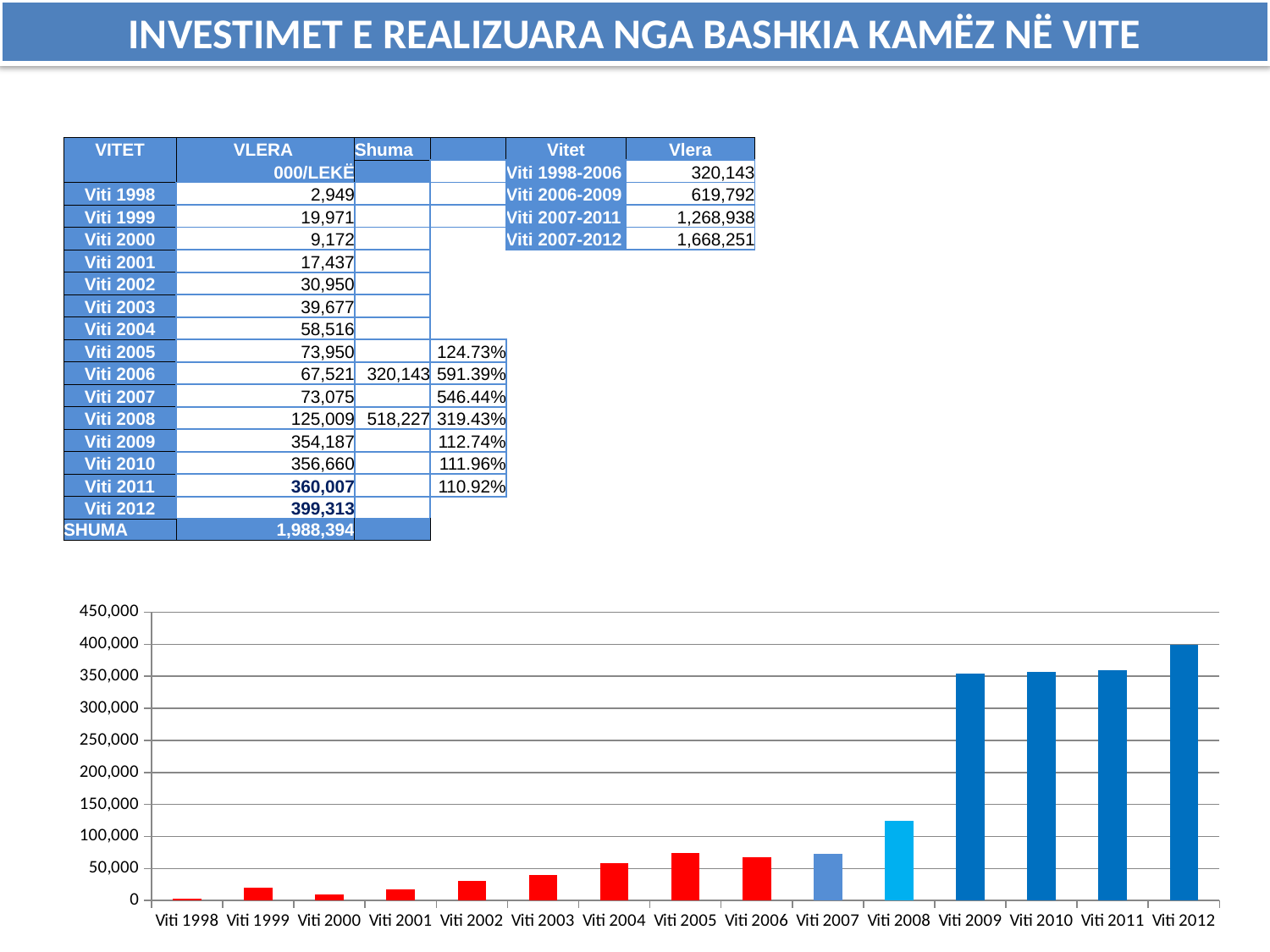
Which year has the tallest bar in the chart? Viti 2012 Do the bar values generally rise or fall from Viti 1998 to Viti 2012? rise Is the bar for Viti 2008 greater or less than 100,000? greater According to the table, what is the value (000/LEKË) for Viti 2012? 399,313 How many years (categories) are plotted on the x axis of the bar chart? 15 According to the table, what is the difference between the values for Viti 2012 and Viti 2011? 39,306 Is the bar for Viti 2003 greater or less than 50,000? less What kind of chart is shown at the bottom of the slide? bar chart Which bar is taller, Viti 2007 or Viti 2008? Viti 2008 Which year has the shortest bar in the chart? Viti 1998 What colour are the bars for Viti 1998 through Viti 2006 in the chart? red Is the bar for Viti 2012 greater or less than 350,000? greater